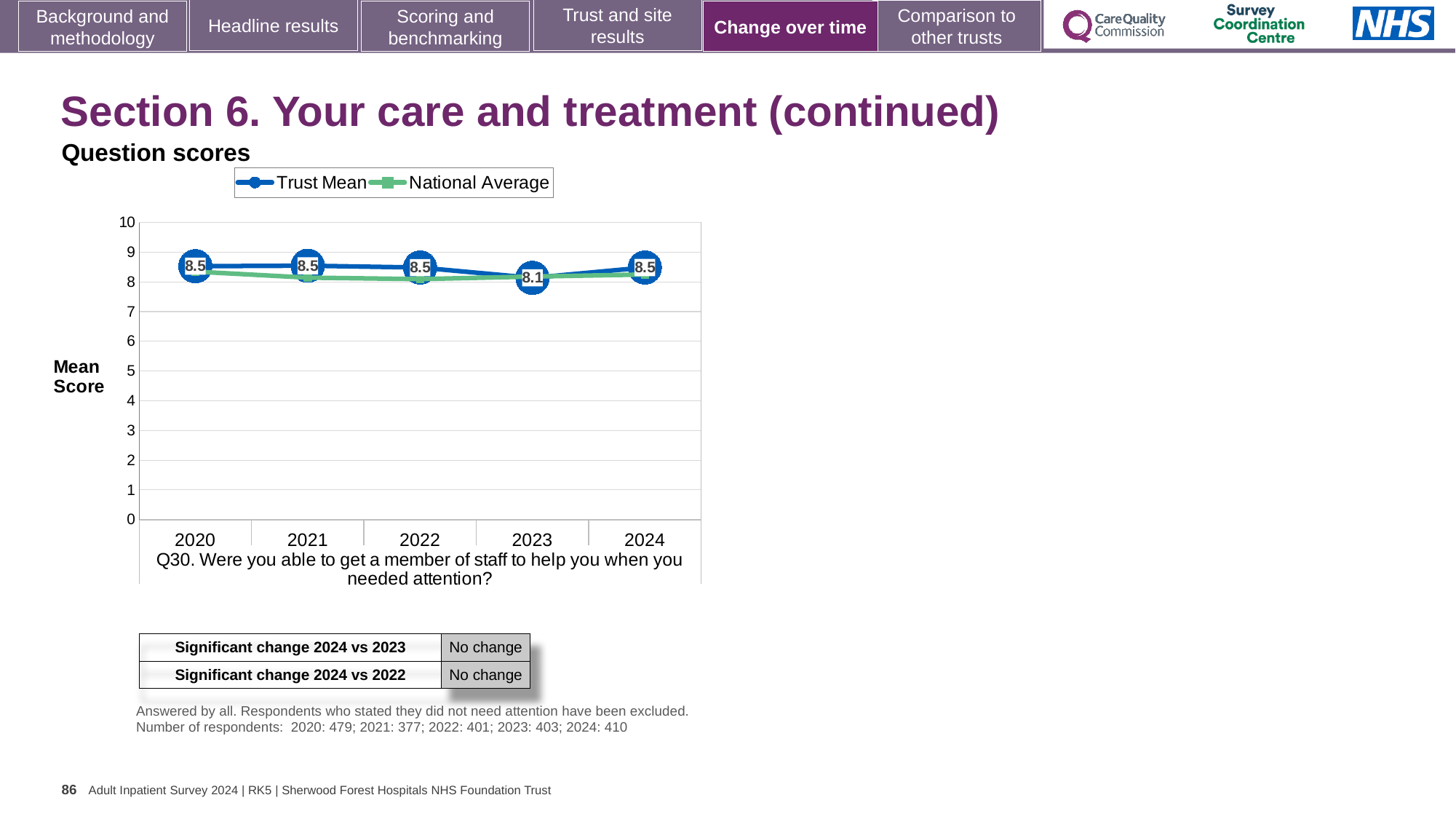
What is the Trust Mean score for 2023? 8.1 How many years are plotted on the x axis? 5 Is the National Average value for 2023 greater or less than 9? less In which year is the Trust Mean score lowest? 2023 Is the Trust Mean score for 2022 larger than the Trust Mean score for 2023? Yes What is the Trust Mean score for 2024? 8.5 What kind of chart is shown? Line chart What is the label of the y axis? Mean Score What is the difference between the Trust Mean score in 2024 and in 2023? 0.4 What is the Trust Mean score for 2020? 8.5 How many series does the legend list? 2 Is the National Average value for 2020 greater or less than 7? greater